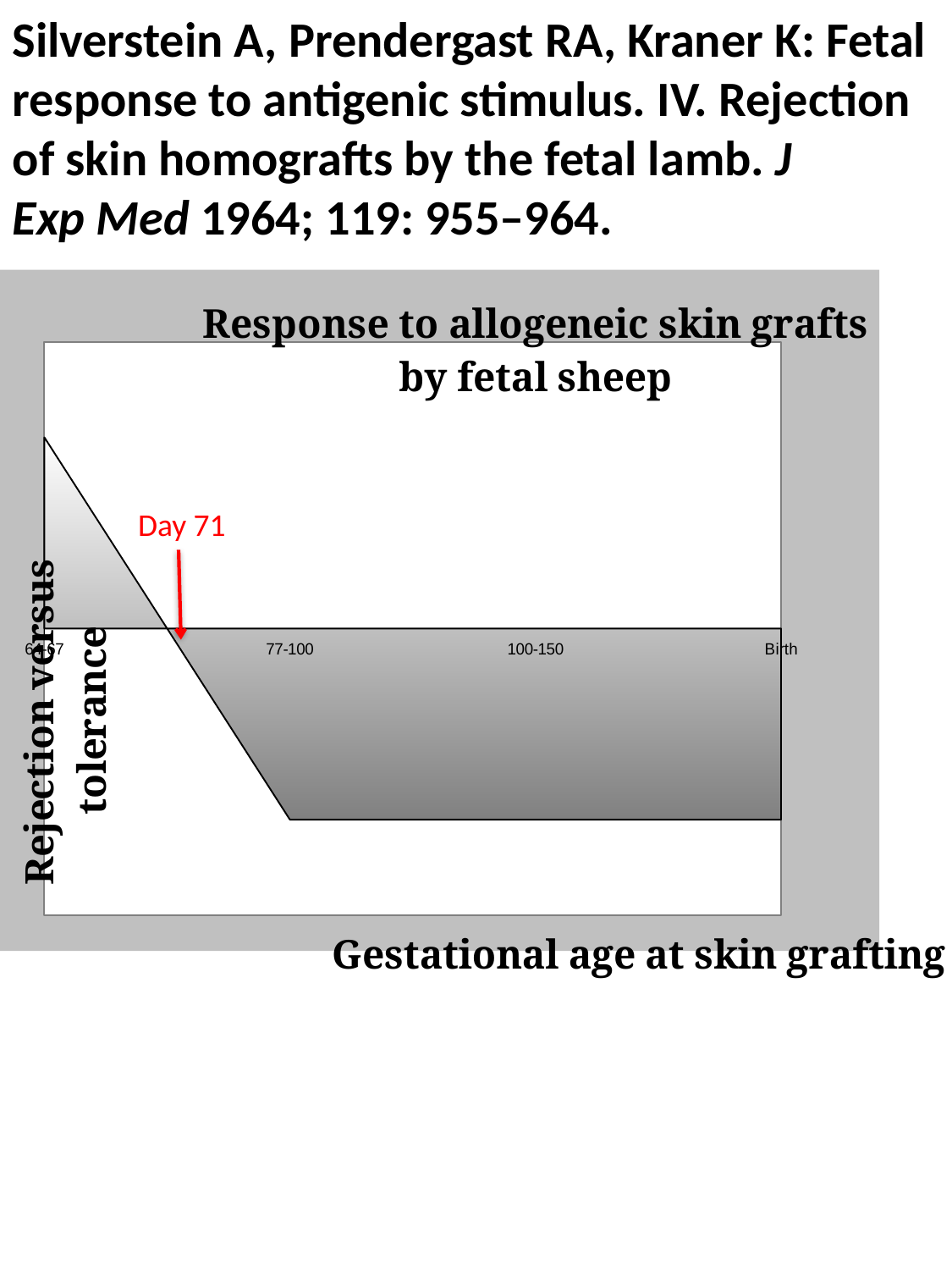
What is the title of the chart? Response to allogeneic skin grafts by fetal sheep Do the plotted values rise or fall as gestational age increases along the x axis? Fall What is the label on the x axis of the chart? Gestational age at skin grafting Is the plotted value at 77-100 larger or smaller than the value at the leftmost category? Smaller Which x-axis category has the highest plotted value? The first (leftmost) category What is the last category label on the x axis of the chart? Birth What kind of chart is shown on the slide? Area chart Is the plotted value at the leftmost category larger or smaller than the value at Birth? Larger What gestational day does the red arrow annotation on the chart point to? Day 71 How many categories are shown along the x axis of the chart? 4